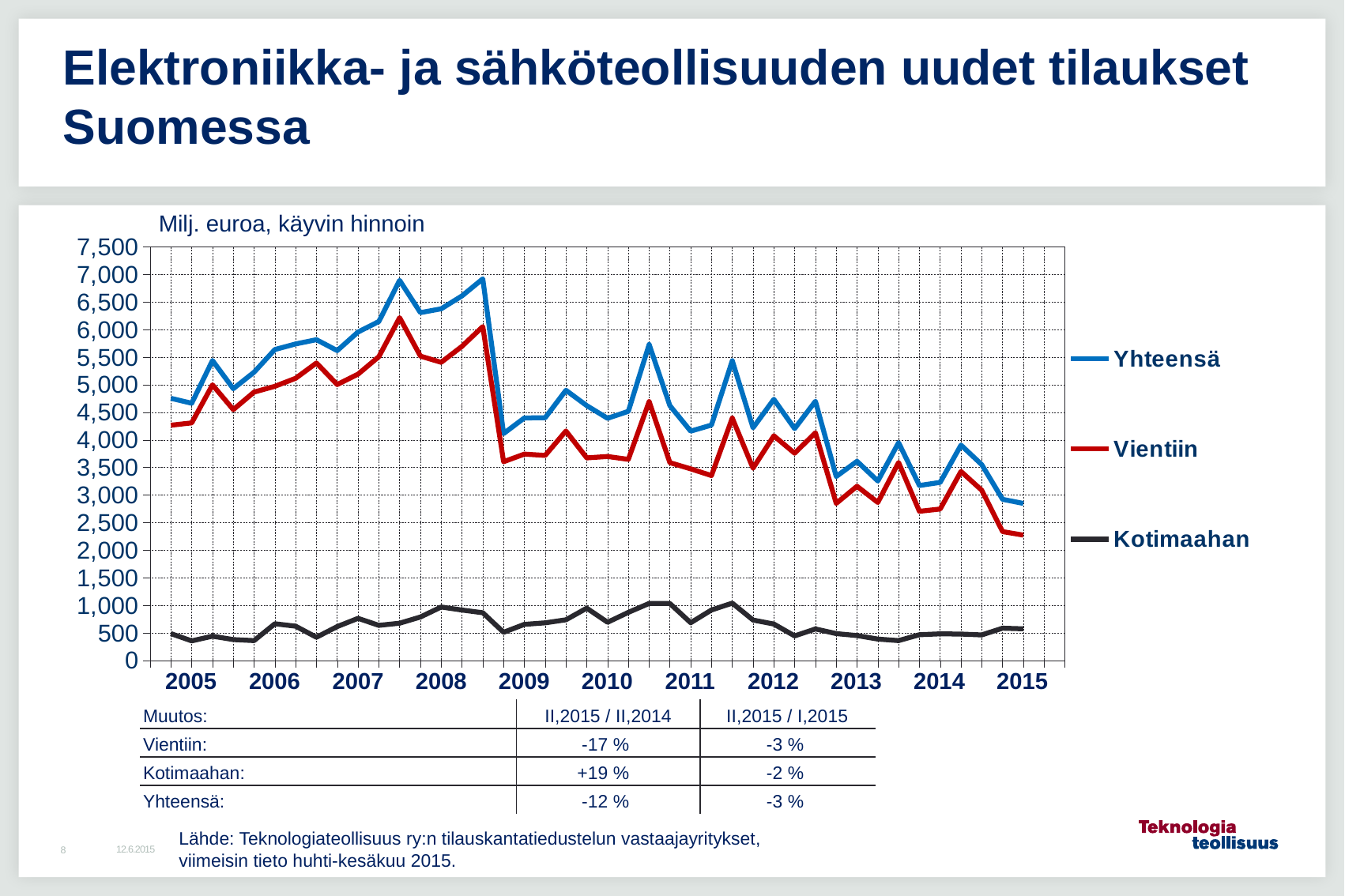
How many year labels are shown on the x axis? 11 Is the peak value of Yhteensä in 2008 greater or less than 6,500? greater How many series does the legend list? 3 What unit label is shown above the chart? Milj. euroa, käyvin hinnoin Which series has the highest values throughout the whole period? Yhteensä Does the Yhteensä series rise or fall overall from 2008 to 2015? fall Is the peak value of Vientiin in 2008 greater or less than 5,500? greater What kind of chart is shown on the slide? line chart Is the value for Vientiin at the end of 2015 greater or less than 2,500? less What are the three series named in the legend? Yhteensä, Vientiin, Kotimaahan Which series has the lowest values throughout the whole period? Kotimaahan